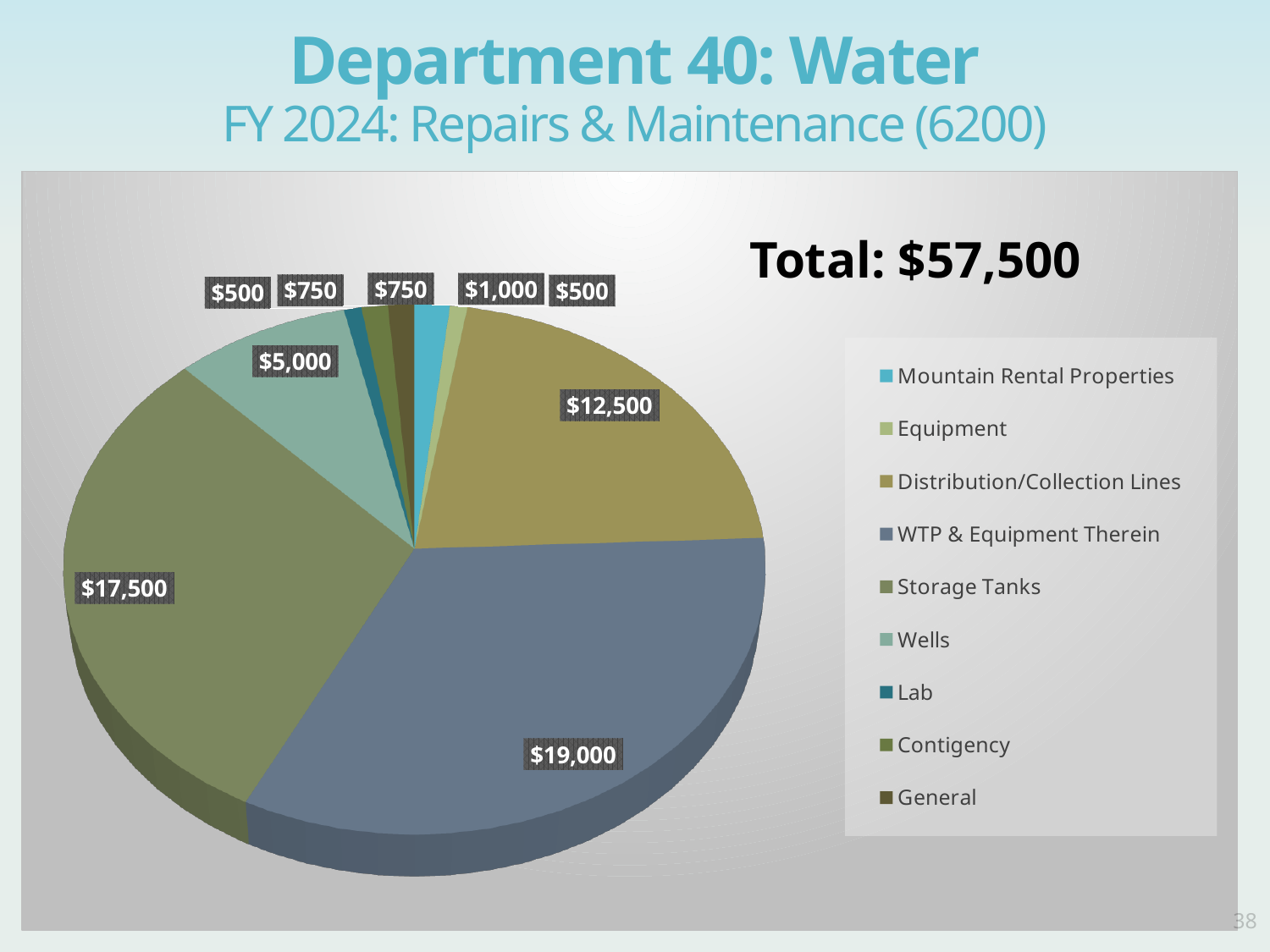
What is the value for WTP & Equipment Therein? $19,000 What is the difference between WTP & Equipment Therein and Storage Tanks? $1,500 What is the total shown for the chart? $57,500 What is the value for Wells? $5,000 What is the value for Mountain Rental Properties? $1,000 Which category has the largest slice of the pie? WTP & Equipment Therein What is the value for Storage Tanks? $17,500 What is the difference between Distribution/Collection Lines and Wells? $7,500 How many categories does the legend list? 9 What is the value for Distribution/Collection Lines? $12,500 Which is larger, Storage Tanks or Distribution/Collection Lines? Storage Tanks What type of chart is shown on the slide? Pie chart